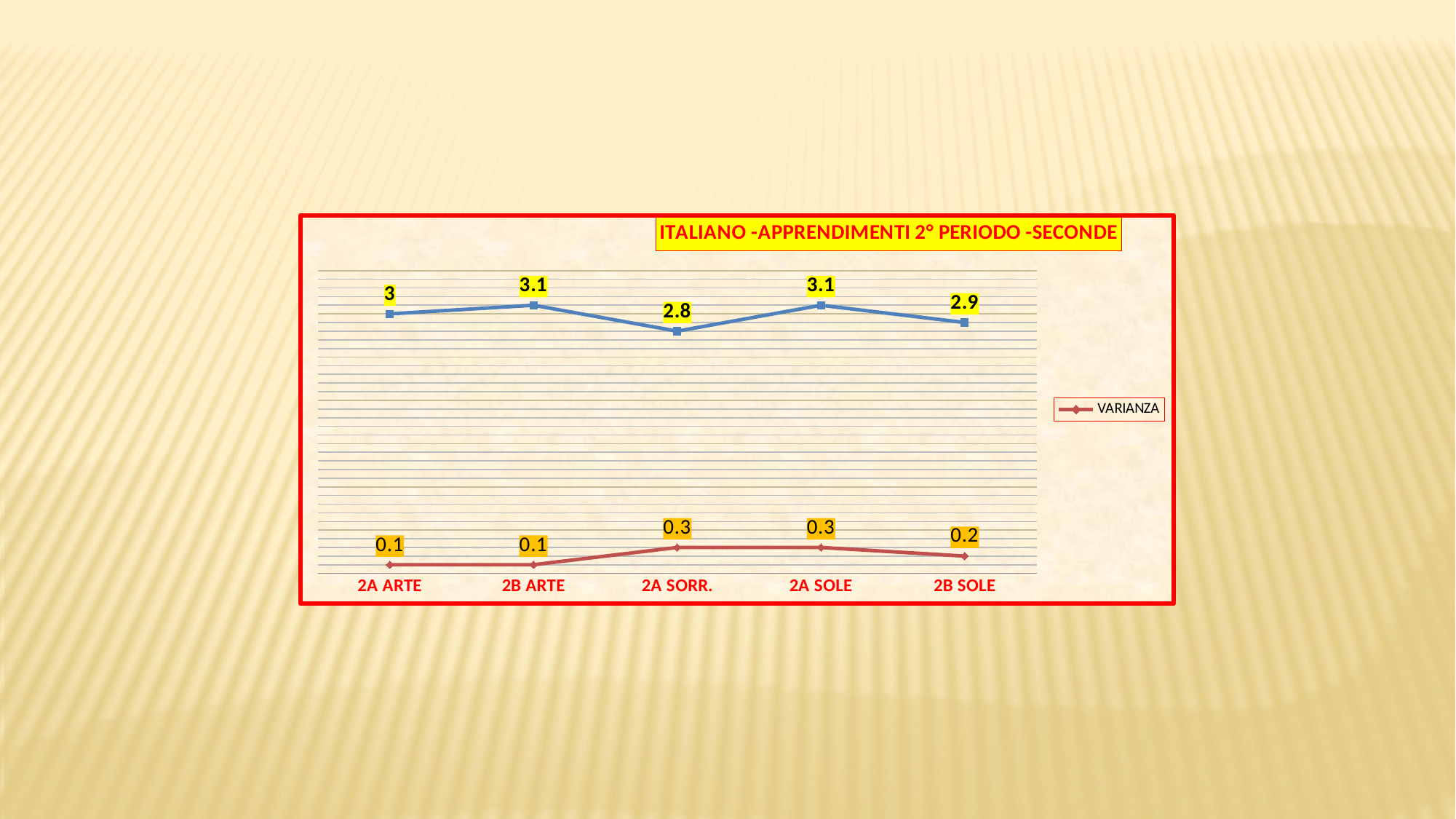
What kind of chart is shown on the slide? Line chart What is the VARIANZA value for 2A SORR.? 0.3 What value does the blue line show for 2A ARTE? 3 Which category has the lowest value on the blue line? 2A SORR. What is the title of the chart? ITALIANO -APPRENDIMENTI 2° PERIODO -SECONDE What value does the blue line show for 2A SORR.? 2.8 What is the VARIANZA value for 2B SOLE? 0.2 What is the difference between the blue line values for 2B ARTE and 2A SORR.? 0.3 What is the difference between the VARIANZA values for 2A SOLE and 2B SOLE? 0.1 How many series does the legend list? 1 How many categories are shown on the x axis? 5 Which has the larger blue line value, 2A ARTE or 2B SOLE? 2A ARTE